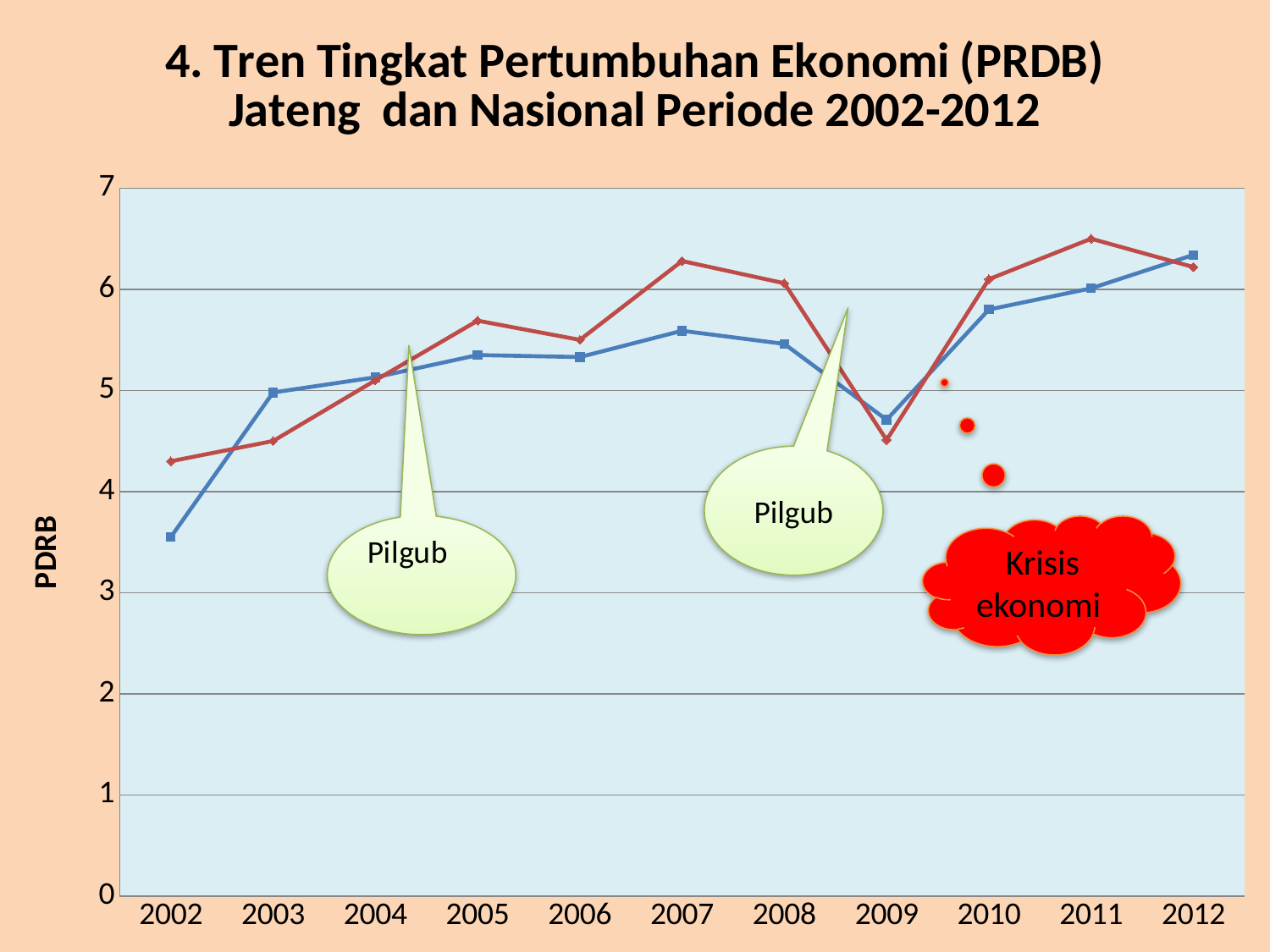
Is the value of the blue line in 2009 greater or less than 5? less How many years are shown along the x axis of the chart? 11 Is the value of the blue line in 2002 greater or less than 4? less In 2007, which line has the higher value, the red line or the blue line? red line Is the value of the blue line in 2012 greater or less than 6? greater In which year does the red line reach its highest value? 2011 In which year does the blue line have its lowest value? 2002 What is the label on the vertical axis of the chart? PDRB What kind of chart is shown on the slide? line chart How many lines are plotted on the chart? 2 Does the blue line rise or fall from 2009 to 2012? rise